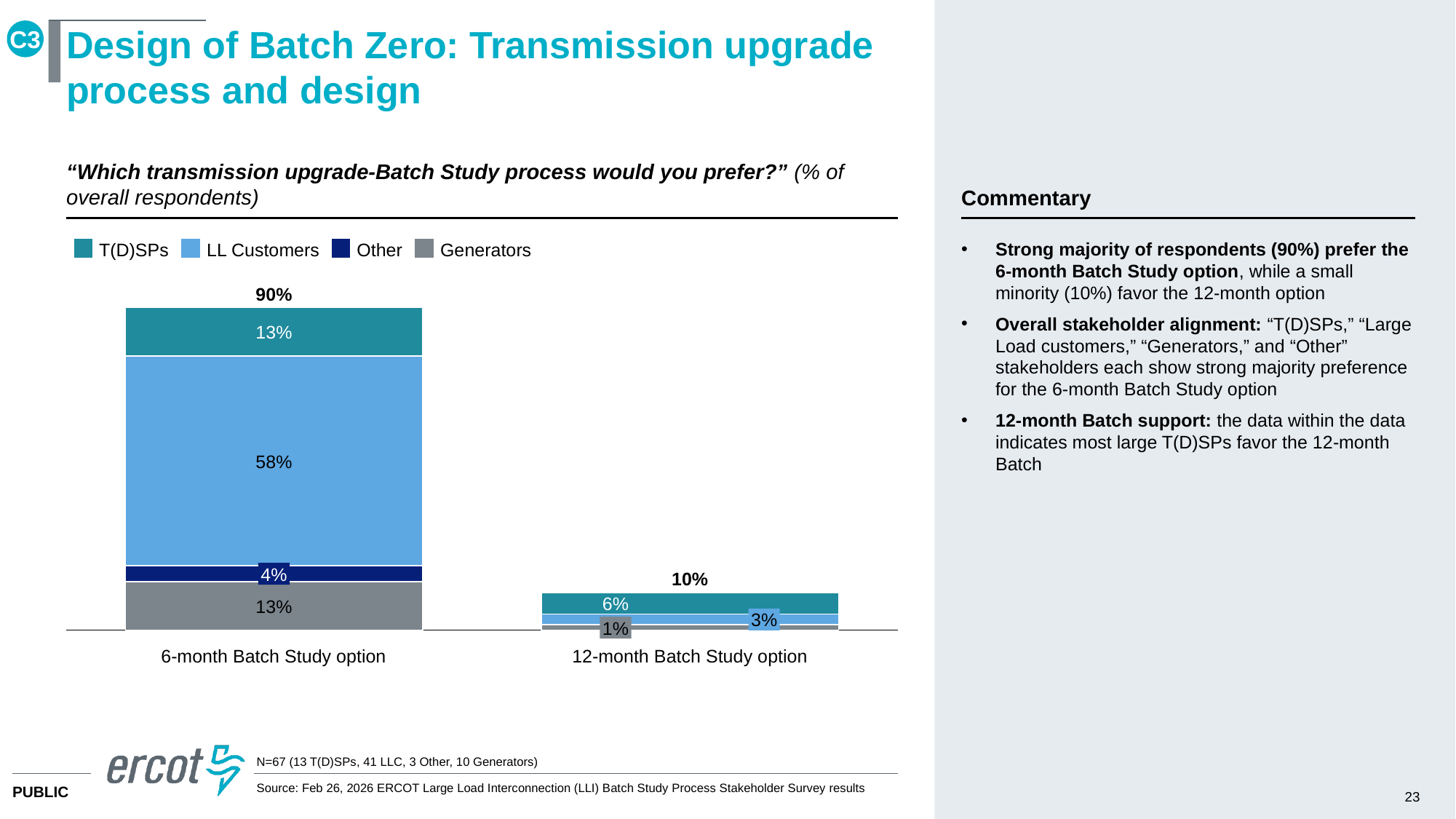
What is the T(D)SPs value for the 12-month Batch Study option? 6% What is the LL Customers value for the 6-month Batch Study option? 58% How many series does the legend list? 4 What type of chart is shown on the slide? Stacked bar chart What is the total share of respondents preferring the 6-month Batch Study option? 90% What is the Other value for the 6-month Batch Study option? 4% What is the total share of respondents preferring the 12-month Batch Study option? 10% Which series is shown in the lightest blue colour in the legend? LL Customers What is the difference between the total for the 6-month option and the total for the 12-month option? 80% Which option has the larger total share of respondents? 6-month Batch Study option How many Batch Study options are shown on the x axis? 2 What is the Generators value for the 6-month Batch Study option? 13%